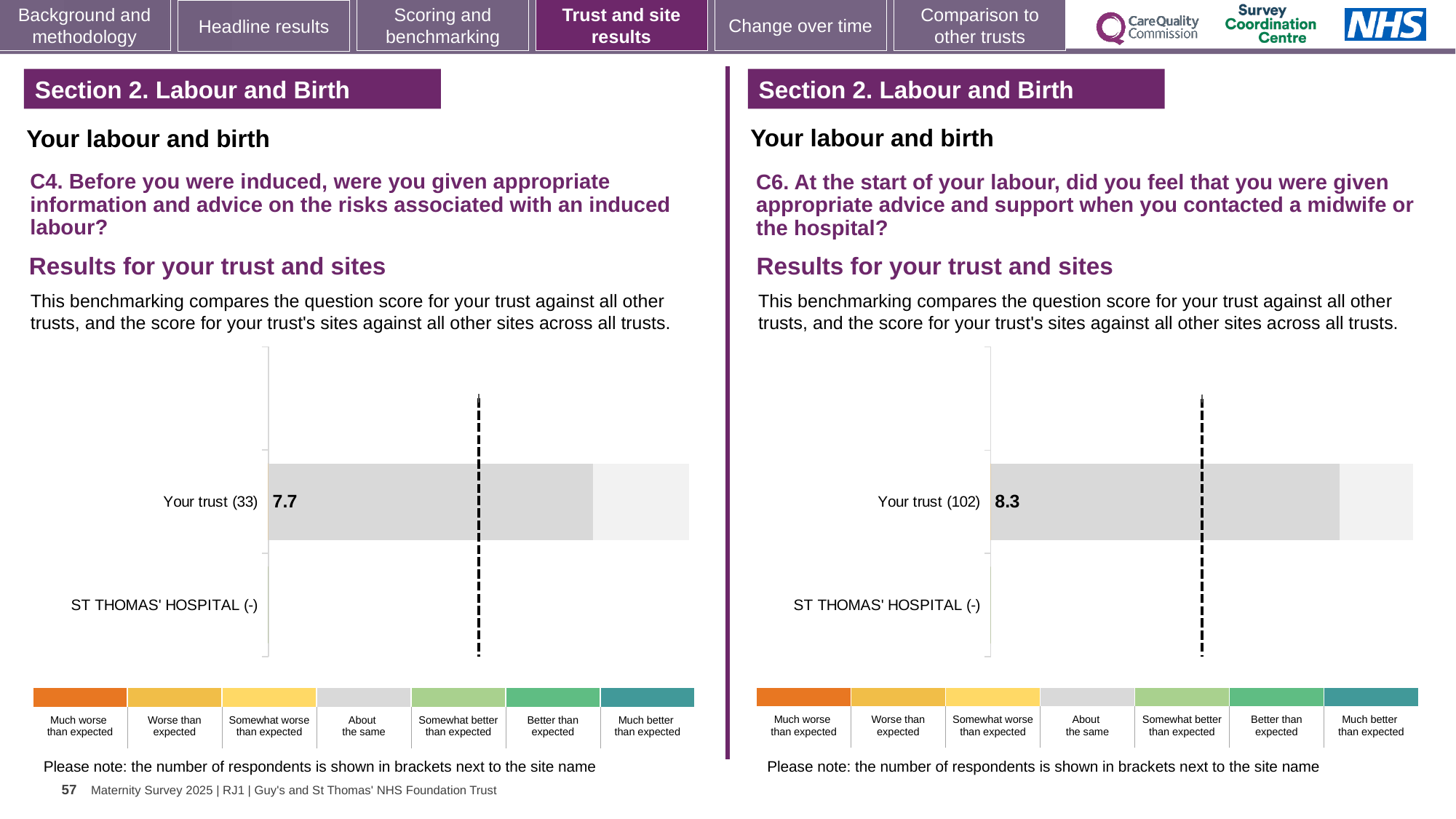
How many colour bands are shown in the legend below the right chart (C6)? 7 On the right chart (C6), which category has the highest score? Your trust (102) On the left chart (C4), which category has no bar plotted? ST THOMAS' HOSPITAL (-) What is the difference between the Your trust score on the right chart (C6) and the Your trust score on the left chart (C4)? 0.6 On the right chart (C6), how many respondents are shown in brackets next to Your trust? 102 On the right chart (C6), what is the score for Your trust? 8.3 On the left chart (C4), what is the score for Your trust? 7.7 Which chart shows a higher score for Your trust, the left chart (C4) or the right chart (C6)? The right chart (C6) What type of chart is used on the left chart (C4)? Bar chart On the left chart (C4), how many respondents are shown in brackets next to Your trust? 33 How many categories are listed on the vertical axis of the right chart (C6)? 2